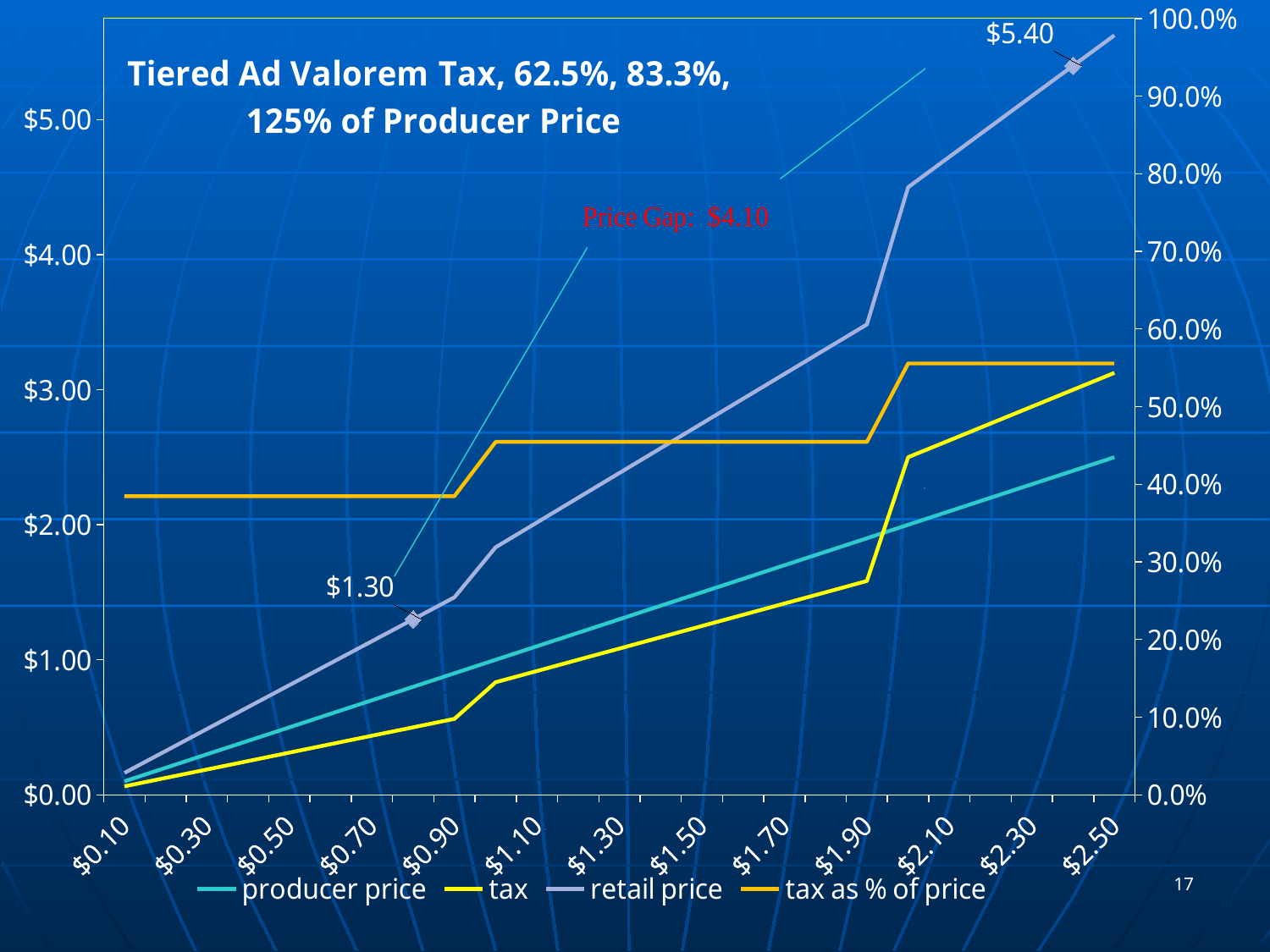
Is the retail price at $2.50 on the x axis greater or less than $5.00? greater What is the difference between the two labeled retail price values, $5.40 and $1.30? $4.10 What kind of chart is shown on the slide? line chart What is the lowest data label shown on the retail price line? $1.30 What price gap value is annotated on the chart? $4.10 Is the tax value at $0.90 on the x axis greater or less than $1.00? less What is the title of the chart? Tiered Ad Valorem Tax, 62.5%, 83.3%, 125% of Producer Price At $2.50 on the x axis, which is larger: the retail price or the producer price? retail price How many series does the legend list? 4 What is the highest data label shown on the retail price line? $5.40 How many labels are shown on the x axis? 13 Does the retail price rise or fall as the producer price increases along the x axis? rise